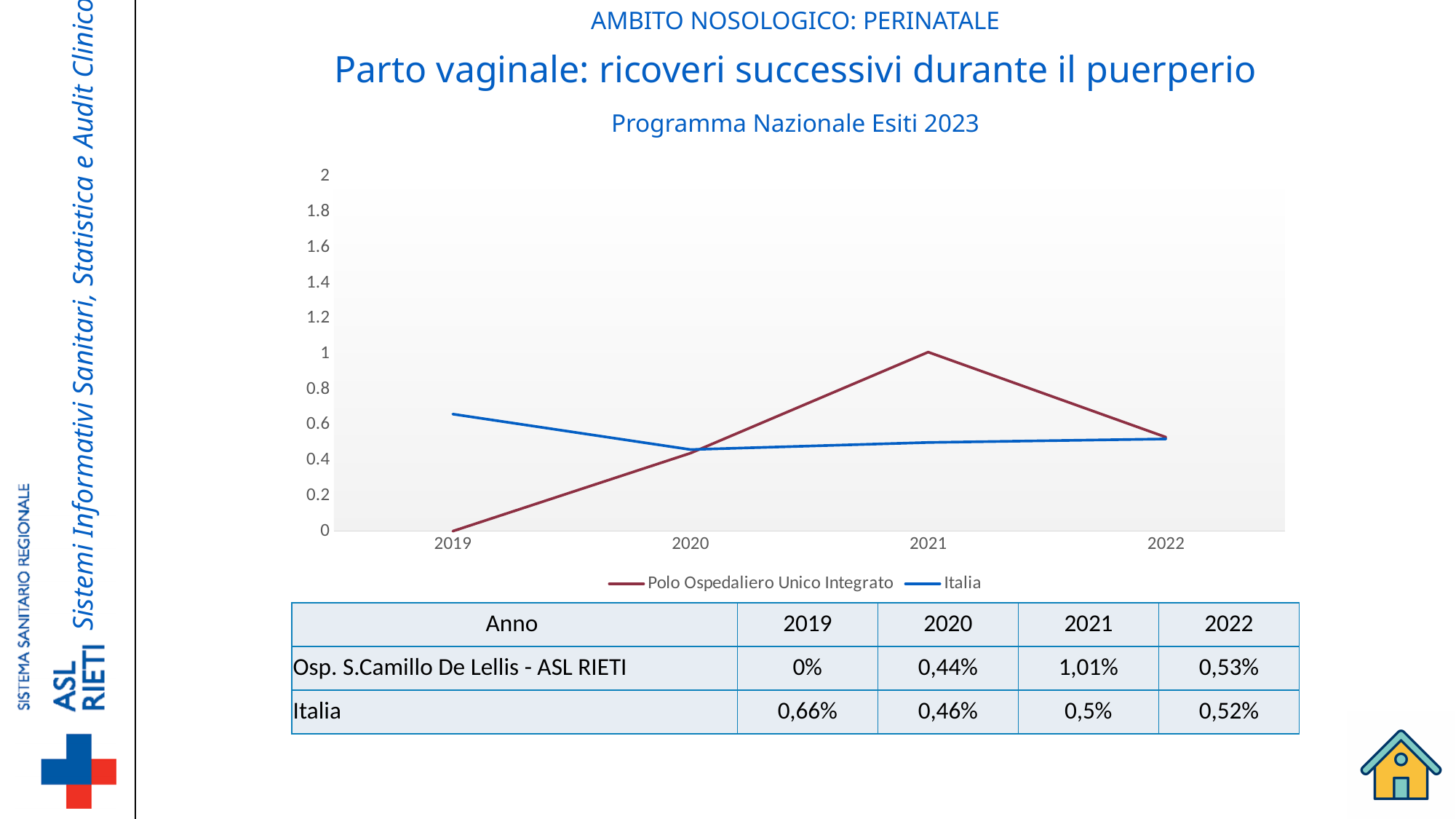
What is the name of the series drawn in blue in the chart legend? Italia What kind of chart is shown on the slide? line chart According to the table, what is the value for Italia in 2022? 0,52% Does the Polo Ospedaliero Unico Integrato line rise or fall from 2019 to 2021? rise How many series does the chart legend list? 2 In which year does the Polo Ospedaliero Unico Integrato line have its lowest value? 2019 In which year does the Polo Ospedaliero Unico Integrato line reach its highest value? 2021 According to the table, what is the value for Italia in 2019? 0,66% According to the table, what is the value for Osp. S.Camillo De Lellis - ASL RIETI in 2021? 1,01% In 2019, which series has the higher value, Polo Ospedaliero Unico Integrato or Italia? Italia Is the value for Polo Ospedaliero Unico Integrato in 2021 greater or less than 0.8? greater How many years are plotted along the x axis of the chart? 4